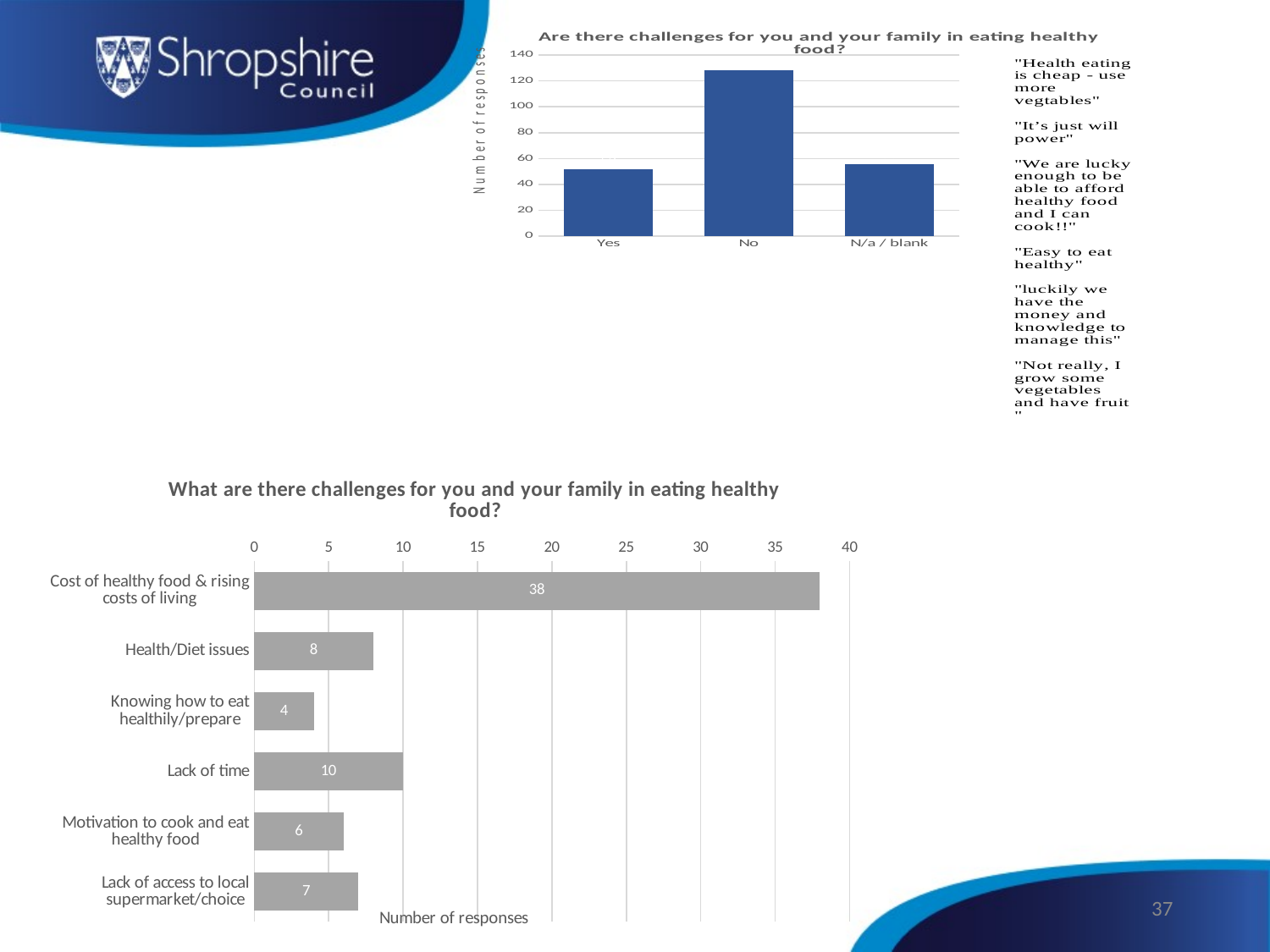
In the top chart 'Are there challenges for you and your family in eating healthy food?', which response category has the highest number of responses? No In the bottom chart 'What are there challenges for you and your family in eating healthy food?', what is the number of responses for 'Cost of healthy food & rising costs of living'? 38 In the bottom chart 'What are there challenges for you and your family in eating healthy food?', which category has the lowest number of responses? Knowing how to eat healthily/prepare In the bottom chart 'What are there challenges for you and your family in eating healthy food?', what is the number of responses for 'Lack of time'? 10 What type of chart is the bottom chart 'What are there challenges for you and your family in eating healthy food?'? Bar chart In the bottom chart 'What are there challenges for you and your family in eating healthy food?', how many categories are listed? 6 In the top chart 'Are there challenges for you and your family in eating healthy food?', what is the label of the y axis? Number of responses In the top chart 'Are there challenges for you and your family in eating healthy food?', how many response categories are shown on the x axis? 3 In the top chart 'Are there challenges for you and your family in eating healthy food?', is the value for 'No' greater or less than 120? greater In the bottom chart 'What are there challenges for you and your family in eating healthy food?', which has more responses: 'Health/Diet issues' or 'Motivation to cook and eat healthy food'? Health/Diet issues In the top chart 'Are there challenges for you and your family in eating healthy food?', is the value for 'Yes' greater or less than 60? less In the bottom chart 'What are there challenges for you and your family in eating healthy food?', what is the difference between the responses for 'Cost of healthy food & rising costs of living' and 'Lack of time'? 28